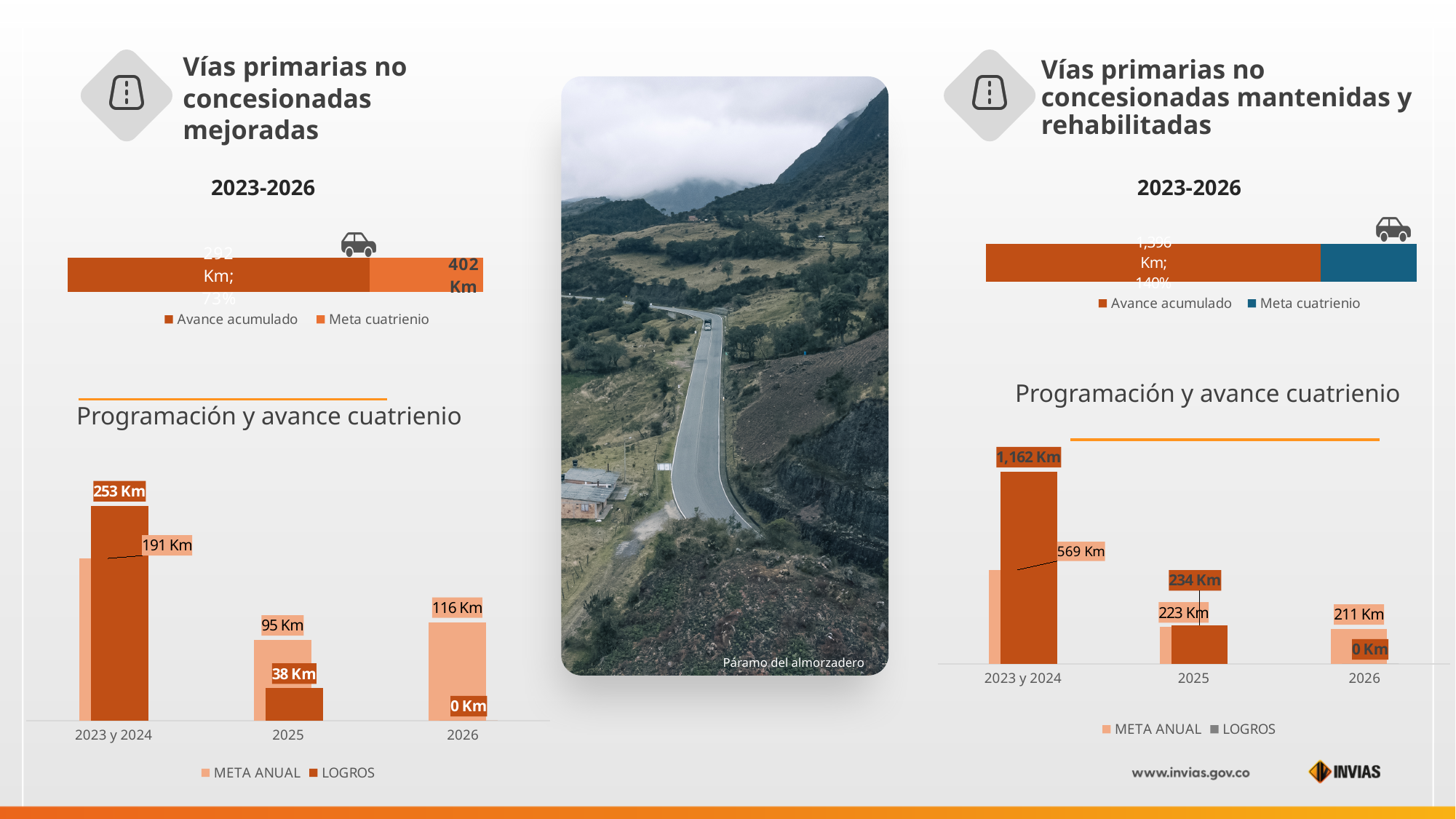
How many series does the legend of the bottom-left bar chart (Vías primarias no concesionadas mejoradas) list? 2 In the bottom-left bar chart (Programación y avance cuatrienio, Vías primarias no concesionadas mejoradas), what is the LOGROS value for 2023 y 2024? 253 Km In the bottom-left bar chart (Vías primarias no concesionadas mejoradas), what is the LOGROS value for 2026? 0 Km In the bottom-left bar chart (Vías primarias no concesionadas mejoradas), what is the difference between META ANUAL and LOGROS for 2025? 57 Km In the bottom-right bar chart (Programación y avance cuatrienio, Vías primarias no concesionadas mantenidas y rehabilitadas), what is the LOGROS value for 2023 y 2024? 1,162 Km What type of chart is the bottom-right chart titled Programación y avance cuatrienio (Vías primarias no concesionadas mantenidas y rehabilitadas)? Bar chart In the bottom-left bar chart (Vías primarias no concesionadas mejoradas), which year has the highest META ANUAL value? 2023 y 2024 In the top-left horizontal bar chart (Vías primarias no concesionadas mejoradas, 2023-2026), what is the Meta cuatrienio value? 402 Km In the bottom-left bar chart (Vías primarias no concesionadas mejoradas), what is the META ANUAL value for 2025? 95 Km In the bottom-right bar chart (Vías primarias no concesionadas mantenidas y rehabilitadas), which is larger for 2025: META ANUAL or LOGROS? LOGROS In the bottom-right bar chart (Vías primarias no concesionadas mantenidas y rehabilitadas), what is the META ANUAL value for 2026? 211 Km In the bottom-right bar chart (Vías primarias no concesionadas mantenidas y rehabilitadas), what is the difference between LOGROS and META ANUAL for 2023 y 2024? 593 Km